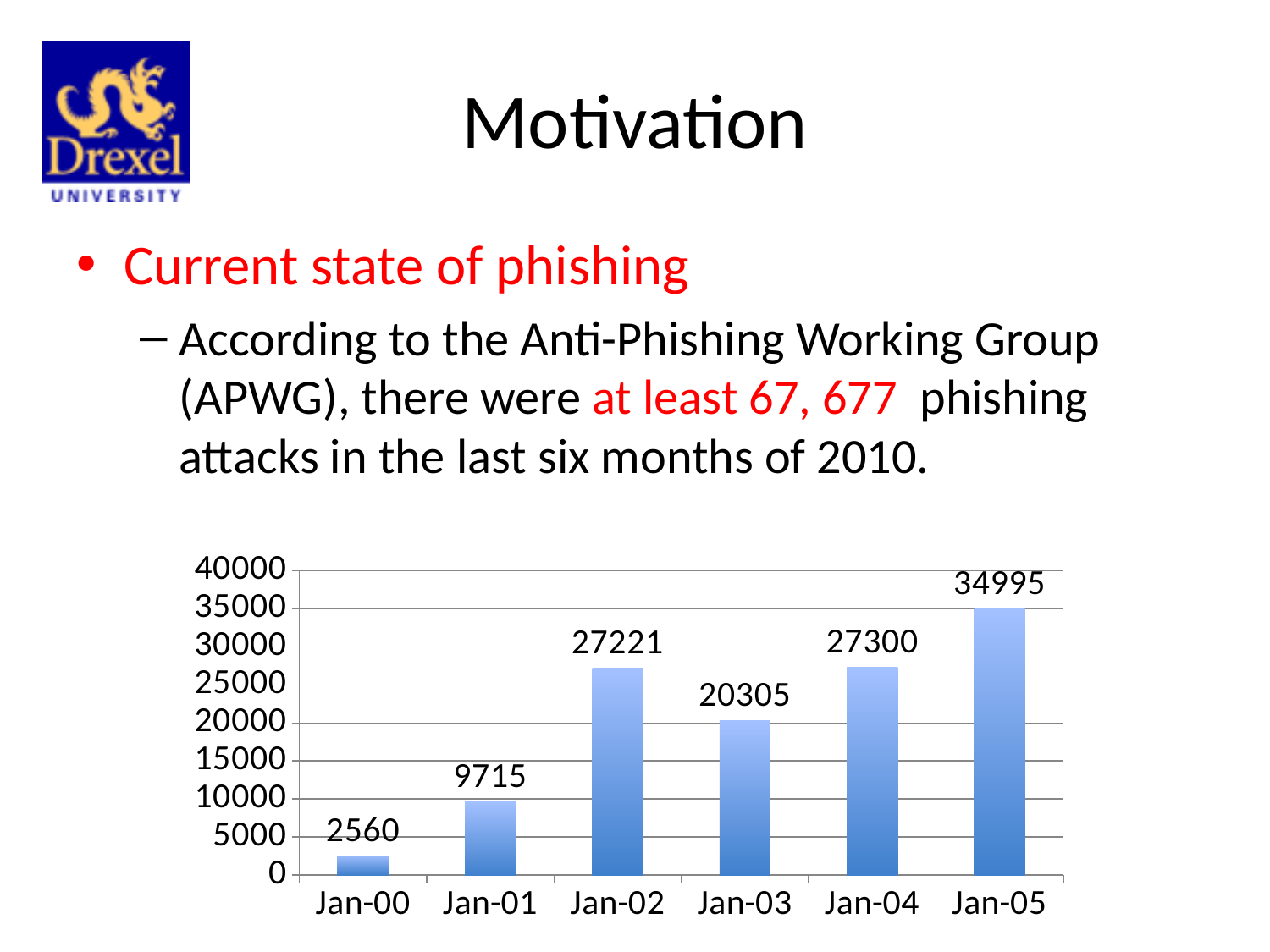
What is the value for Jan-03? 20305 Is the value for Jan-04 greater or less than 25000? greater What is the highest value shown on the y axis? 40000 What is the difference between the values for Jan-01 and Jan-00? 7155 Which is larger, the value for Jan-02 or the value for Jan-03? Jan-02 Which category has the lowest value? Jan-00 What is the difference between the values for Jan-05 and Jan-04? 7695 What is the value for Jan-00? 2560 What is the value for Jan-05? 34995 How many categories are shown on the x axis? 6 What kind of chart is shown on the slide? bar chart Which category has the highest value? Jan-05